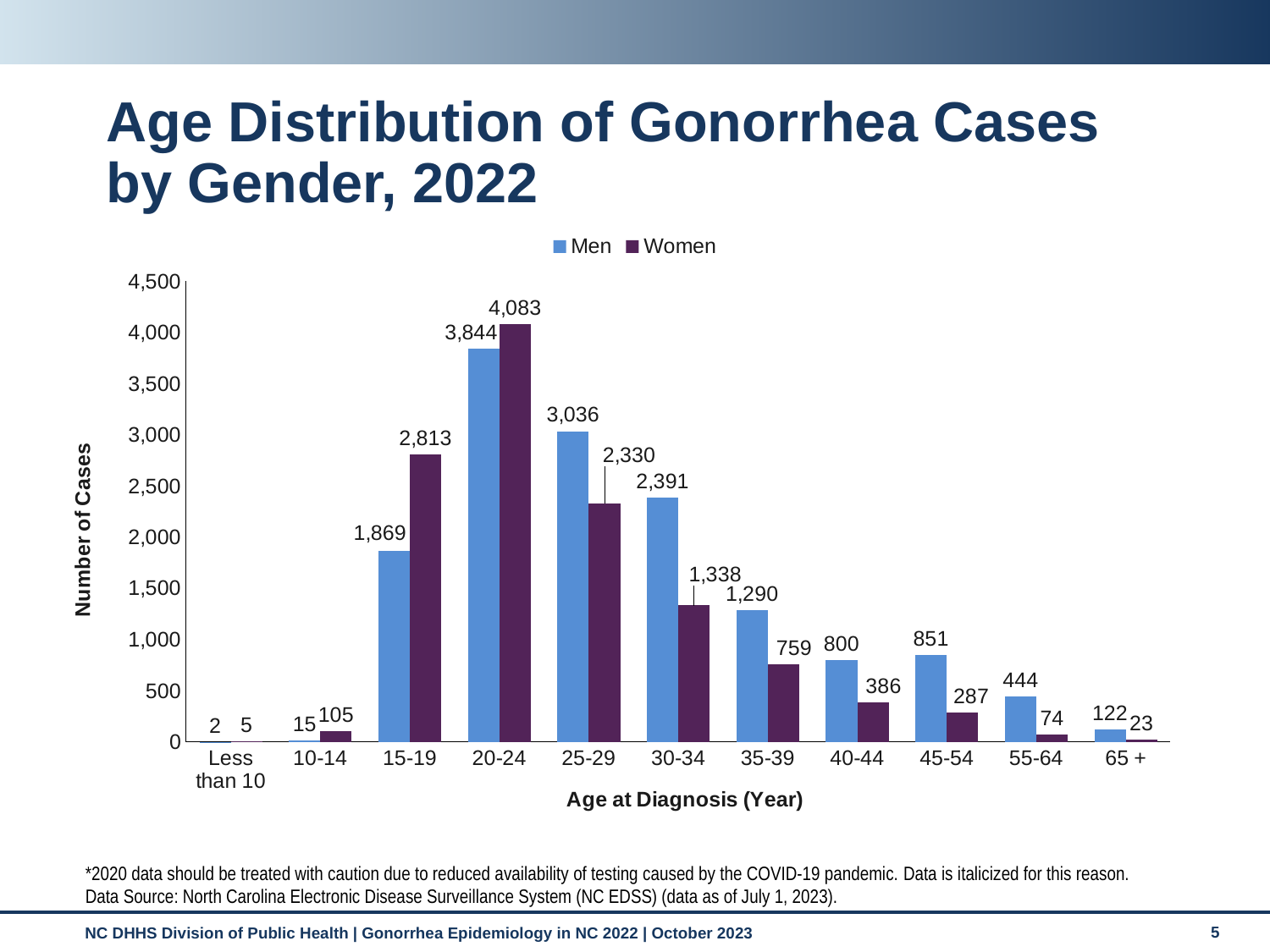
In the 30-34 age group, which series has more cases, Men or Women? Men How many age categories are shown on the x axis? 11 Which age group has the highest number of cases for Women? 20-24 How many series does the legend list? 2 What is the number of gonorrhea cases for Men in the 20-24 age group? 3,844 What is the difference between Men and Women cases in the 25-29 age group? 706 What is the label of the y axis? Number of Cases Is the value for Men in the 45-54 age group greater or less than 500? greater What type of chart is shown on the slide? bar chart What is the number of cases for Women in the 10-14 age group? 105 What is the number of gonorrhea cases for Women in the 15-19 age group? 2,813 Which age group has the lowest number of cases for Men? Less than 10